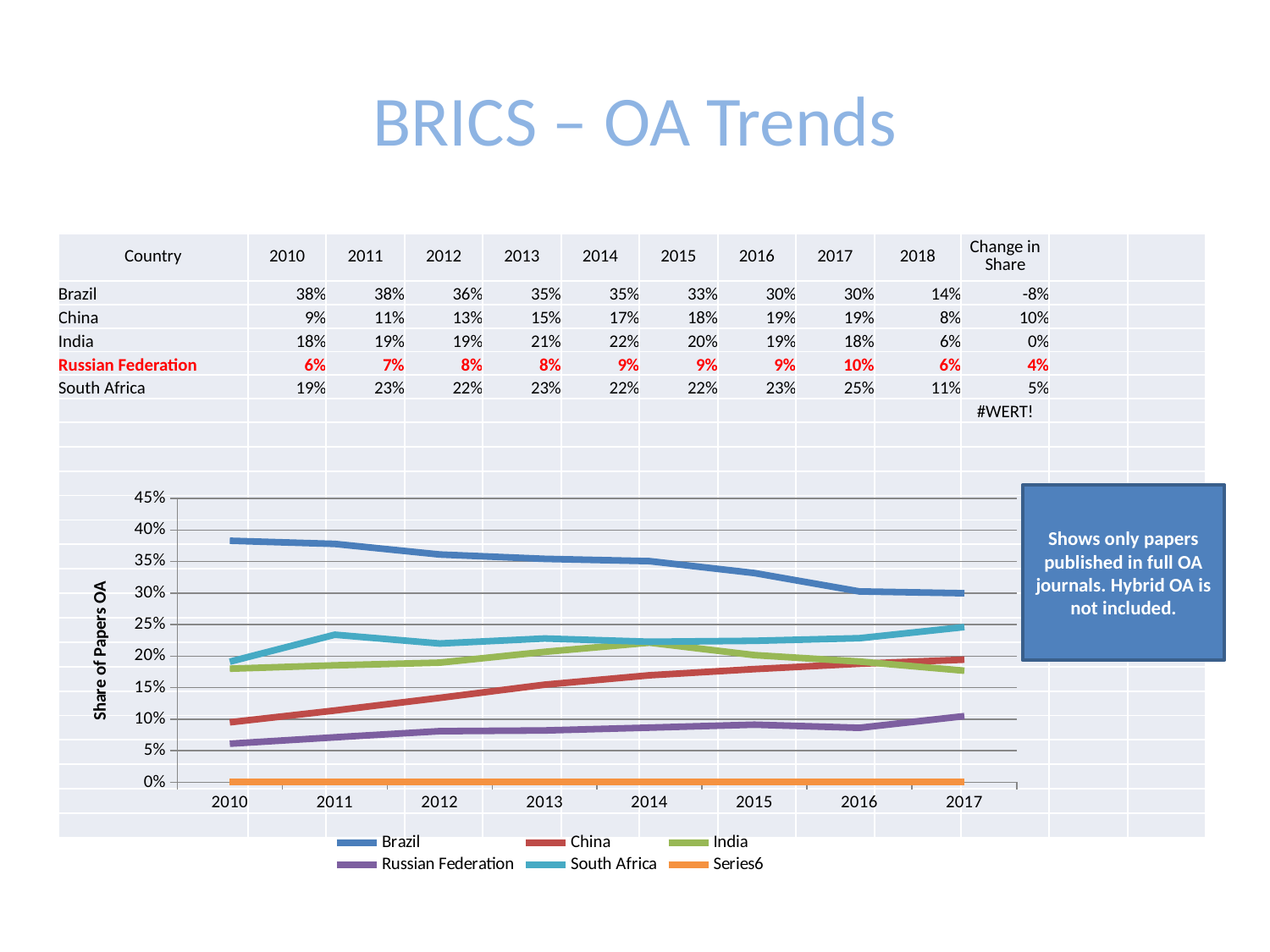
Which country has the highest share of papers OA in 2010? Brazil Which country has the lowest share of papers OA in 2017? Russian Federation Does the China line rise or fall from 2010 to 2017? rise How many years are plotted along the x axis of the chart? 8 What is the difference between Brazil's and the Russian Federation's share of papers OA in 2010? 32 percentage points What kind of chart is shown on the slide? line chart In 2017, which is larger: the share for South Africa or the share for India? South Africa What is the title of the chart's y axis? Share of Papers OA What is the share of papers OA for Brazil in 2010? 38% How many series does the chart legend list? 6 What is the share of papers OA for China in 2017? 19% Does the Brazil line rise or fall from 2010 to 2017? fall